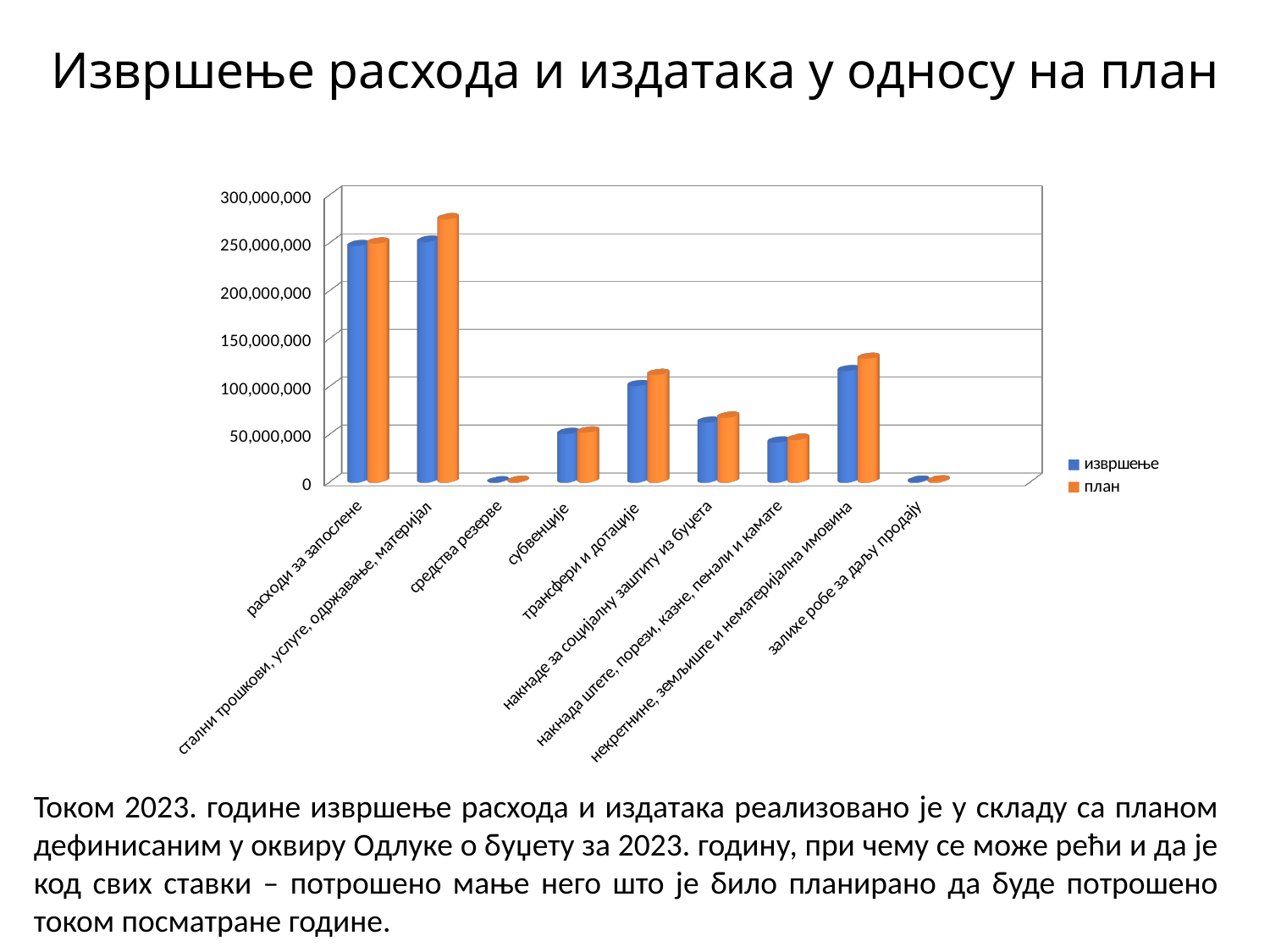
Is the извршење value for накнада штете, порези, казне, пенали и камате greater or less than 50,000,000? less Which category has the highest план value? стални трошкови, услуге, одржавање, материјал Which colour represents the план series in the chart? orange What kind of chart is shown on the slide? bar chart Is the план value for некретнине, земљиште и нематеријална имовина greater or less than 100,000,000? greater How many categories are shown on the x axis of the chart? 9 What is the title of the slide containing the chart? Извршење расхода и издатака у односу на план How many series does the legend list? 2 Is the извршење value for трансфери и дотације greater or less than 150,000,000? less Which is larger: the план value for трансфери и дотације or the план value for некретнине, земљиште и нематеријална имовина? некретнине, земљиште и нематеријална имовина Which is larger: the извршење value for субвенције or the извршење value for накнаде за социјалну заштиту из буџета? накнаде за социјалну заштиту из буџета